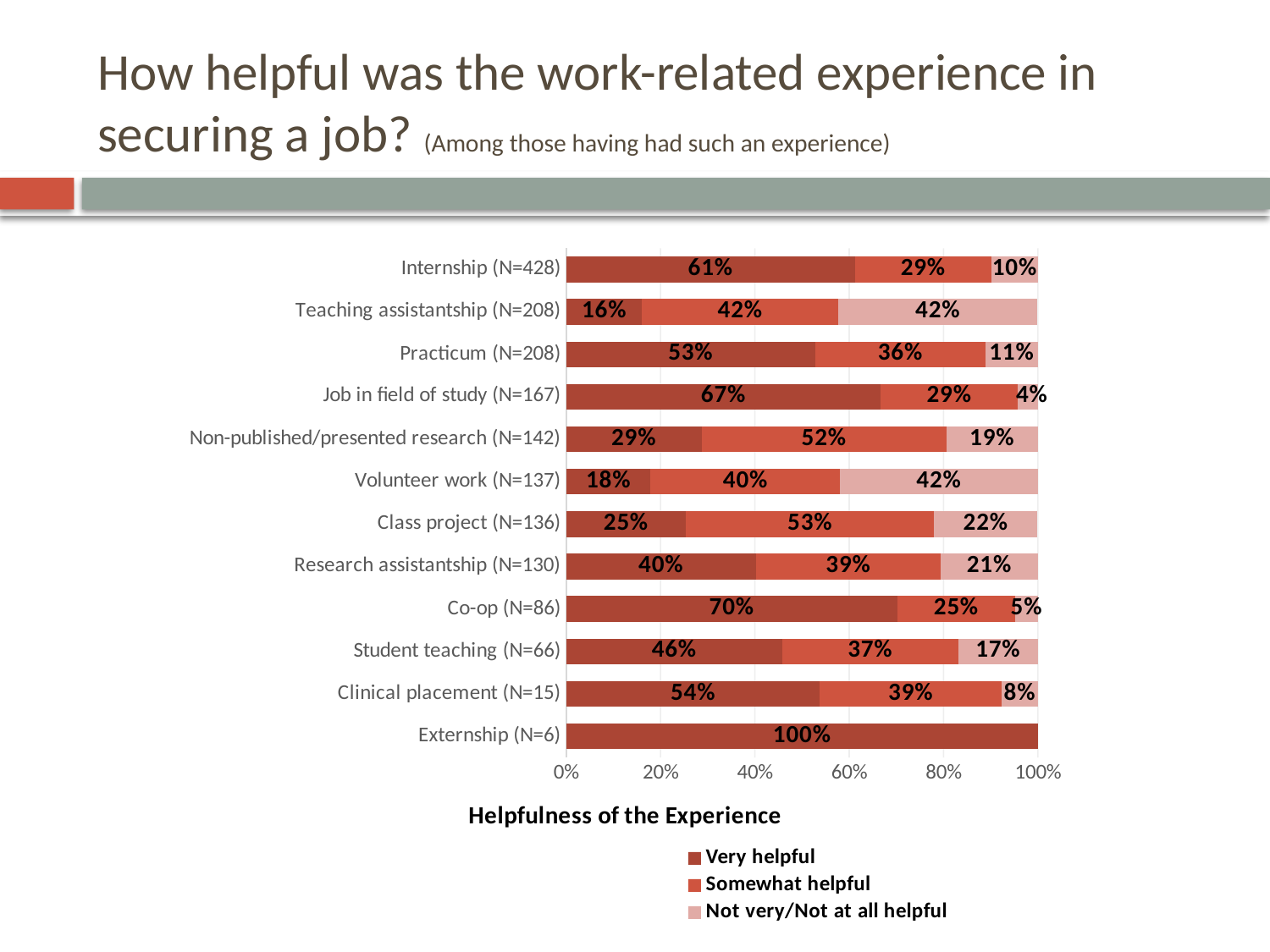
What percentage of Internship respondents said the experience was Very helpful? 61% How many series does the legend list? 3 Which has a larger Very helpful percentage, Practicum or Student teaching? Practicum What is the difference between the Very helpful percentages for Co-op and Research assistantship? 30% What is the sample size (N) for Volunteer work? 137 How many work-related experience categories are shown in the chart? 12 What kind of chart is shown on the slide? Stacked bar chart What percentage of Teaching assistantship respondents said the experience was Not very/Not at all helpful? 42% Which work-related experience has the lowest Very helpful percentage? Teaching assistantship (N=208) Which work-related experience has the highest Very helpful percentage? Externship (N=6) What is the x-axis title of the chart? Helpfulness of the Experience What percentage of Co-op respondents said the experience was Somewhat helpful? 25%